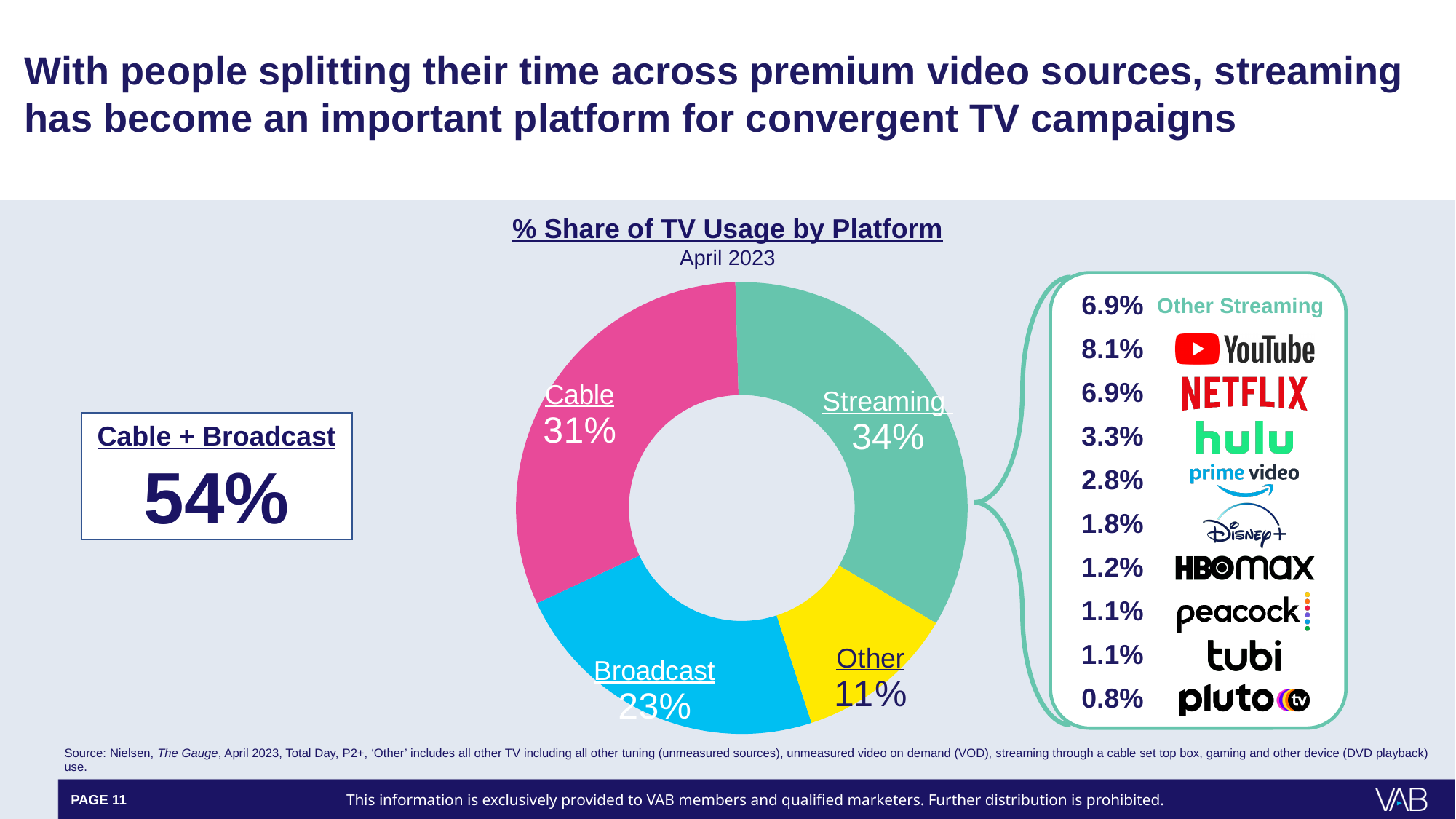
Which platform has the largest share of TV usage? Streaming Which platform has the smallest share of TV usage? Other What is the share of TV usage for Streaming in the donut chart? 34% How many platform categories are shown in the donut chart? 4 What is the share of TV usage for Other? 11% What is the combined share of Cable and Broadcast shown on the slide? 54% Which has a larger share of TV usage, Streaming or Cable? Streaming What is the difference in share between Cable and Broadcast? 8% In the streaming breakdown, what share does YouTube have? 8.1% What is the share of TV usage for Broadcast? 23% What kind of chart is used to show % Share of TV Usage by Platform? Donut (pie) chart What is the share of TV usage for Cable? 31%